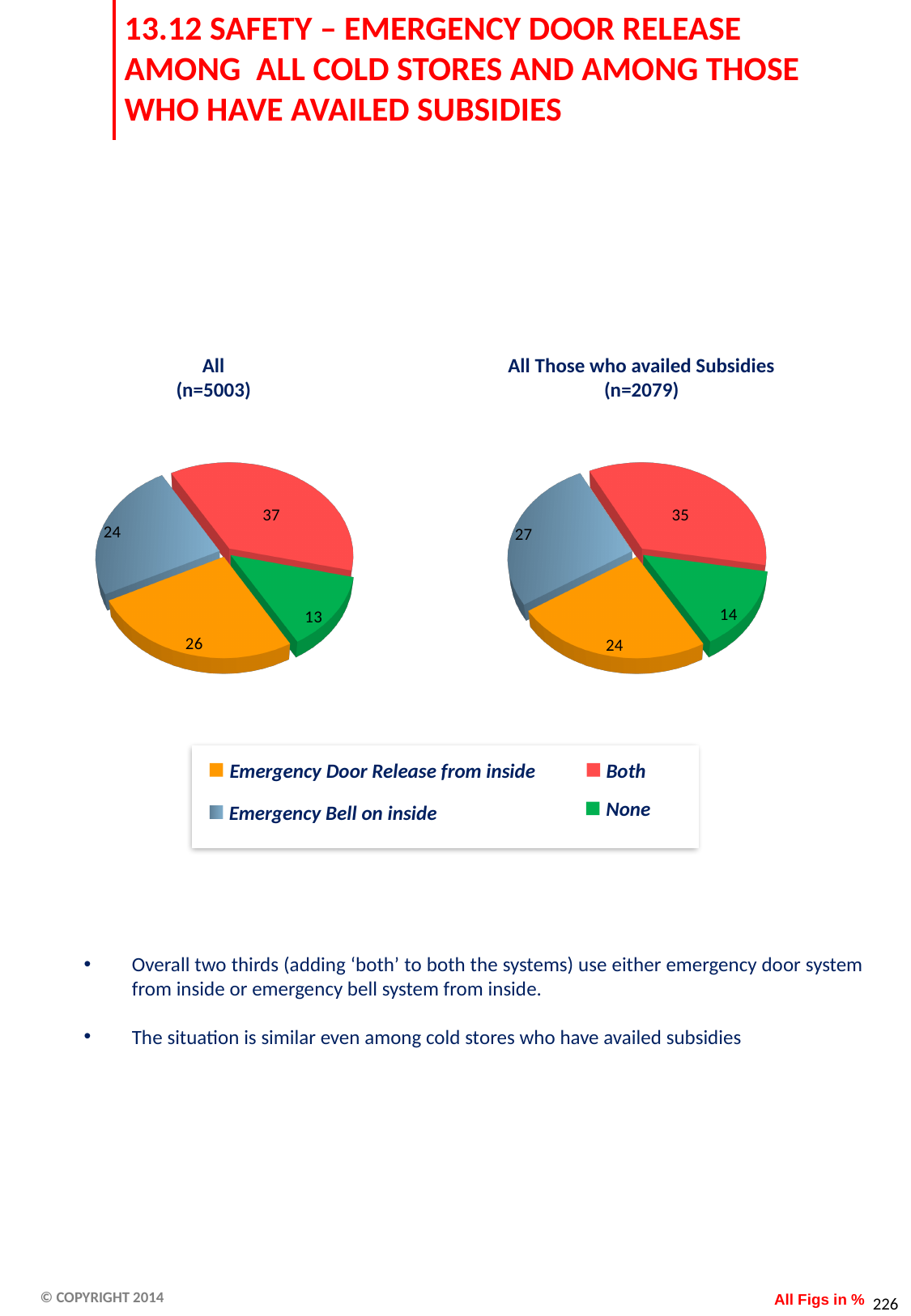
What type of chart is used on this slide? Pie chart How many slices does the 'All (n=5003)' pie chart have? 4 In the 'All (n=5003)' pie chart, what is the difference between the values for 'Both' and 'None'? 24 In the 'All (n=5003)' pie chart, what is the value for 'Both'? 37 In the 'All Those who availed Subsidies (n=2079)' pie chart, which category has the smallest slice? None In the 'All Those who availed Subsidies (n=2079)' pie chart, what is the value for 'None'? 14 What colour represents 'None' in the pie charts? Green In the 'All Those who availed Subsidies (n=2079)' pie chart, what is the value for 'Emergency Bell on inside'? 27 In the 'All Those who availed Subsidies (n=2079)' pie chart, which is larger: 'Emergency Bell on inside' or 'Emergency Door Release from inside'? Emergency Bell on inside How many entries does the legend list? 4 In the 'All (n=5003)' pie chart, what is the value for 'Emergency Door Release from inside'? 26 In the 'All (n=5003)' pie chart, which category has the largest slice? Both